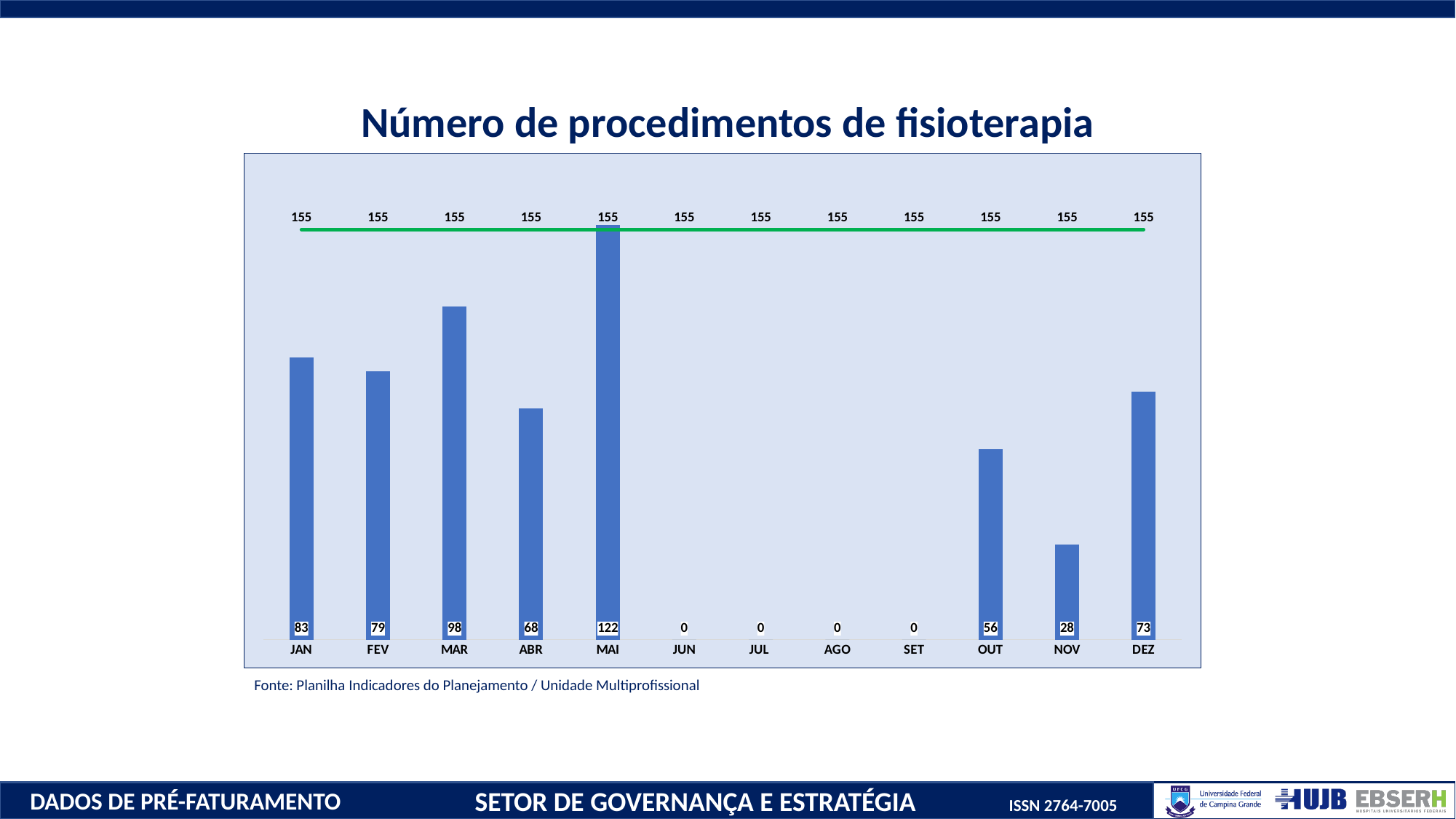
What is the value of the green target line shown for each month? 155 How many months are shown on the x axis? 12 What kind of chart is this? bar chart What is the difference between the values for JAN and FEV? 4 What is the value for MAI? 122 What is the value for NOV? 28 What is the title of the chart? Número de procedimentos de fisioterapia Which is larger, the value for OUT or the value for DEZ? DEZ What is the difference between the values for MAI and MAR? 24 How many months have a value of 0? 4 Which month has the highest number of procedures? MAI What is the value for MAR? 98